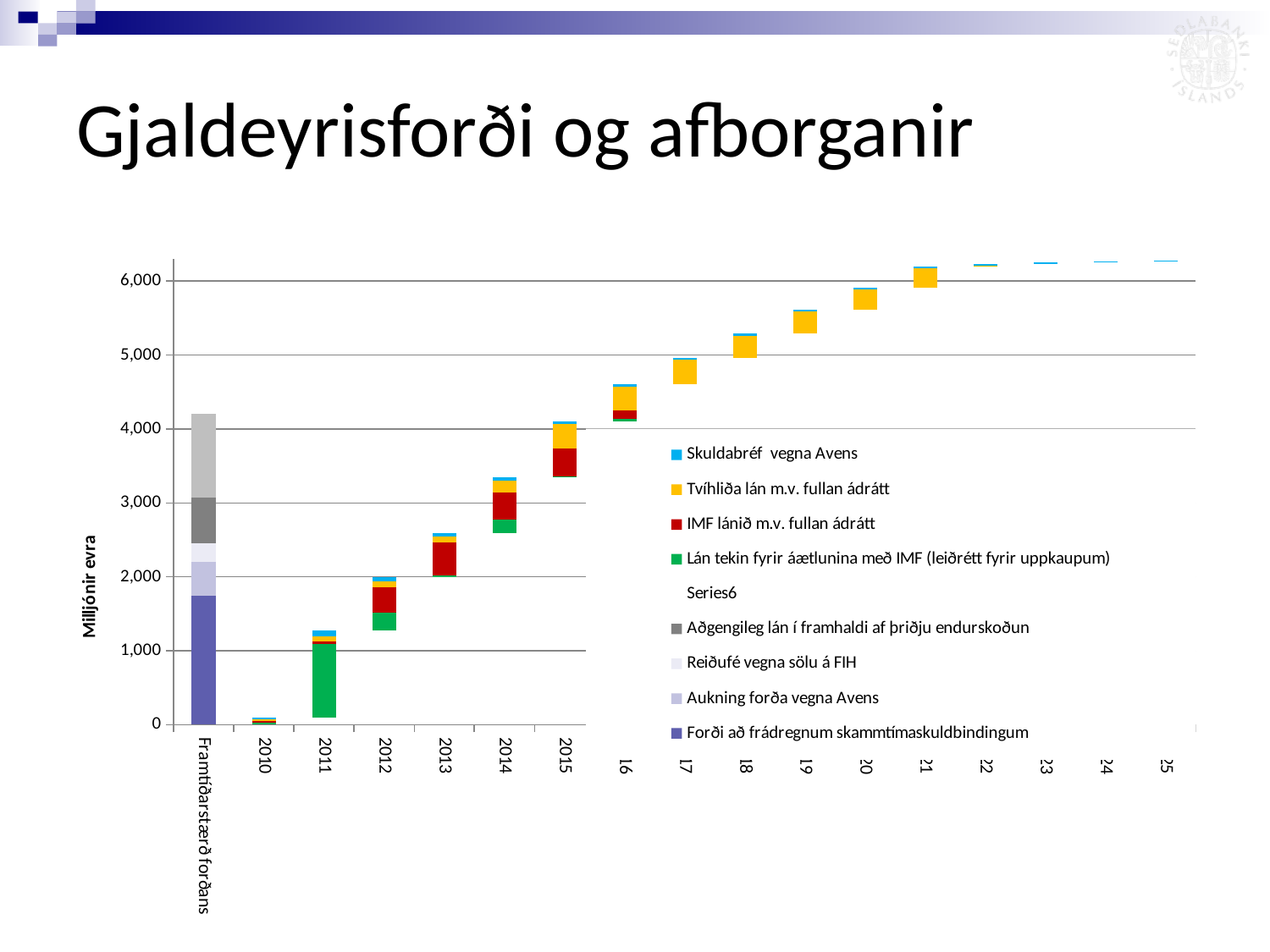
What kind of chart is shown on the slide? bar chart How many series does the legend list? 9 What is the title of the y axis? Milljónir evra Do the floating bars rise or fall along the x axis from 2010 to 25? rise Is the value for 2010 greater or less than 1,000? less Is the top of the bar for 2014 greater or less than 3,000? greater Is the top of the bar for Framtíðarstærð forðans greater or less than 3,000? greater Which bar is taller, 2010 or 2011? 2011 Which legend entry is shown in red? IMF lánið m.v. fullan ádrátt How many categories are shown along the x axis? 17